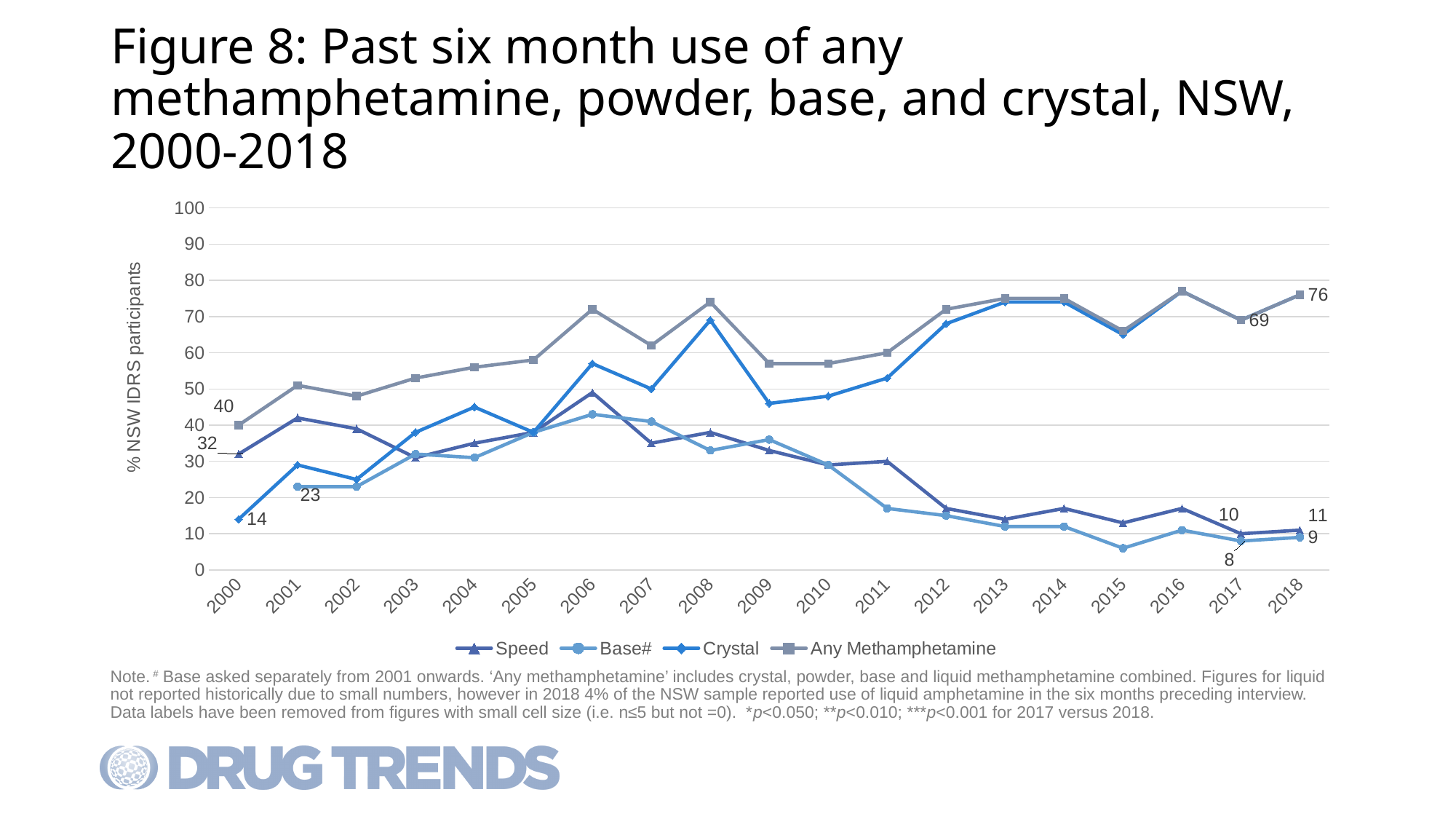
What is the label on the y axis? % NSW IDRS participants What is the value for Any Methamphetamine in 2000? 40 Is the value for Crystal in 2012 greater or less than 60? greater What is the difference between the Speed value and the Base# value in 2018? 2 What is the value for Crystal in 2000? 14 What is the value for Speed in 2000? 32 Which series has the lowest value in 2018? Base# What is the value for Speed in 2018? 11 How many years are plotted along the x axis? 19 What kind of chart is shown on the slide? Line chart How many series does the legend list? 4 What is the value for Base# in 2001? 23